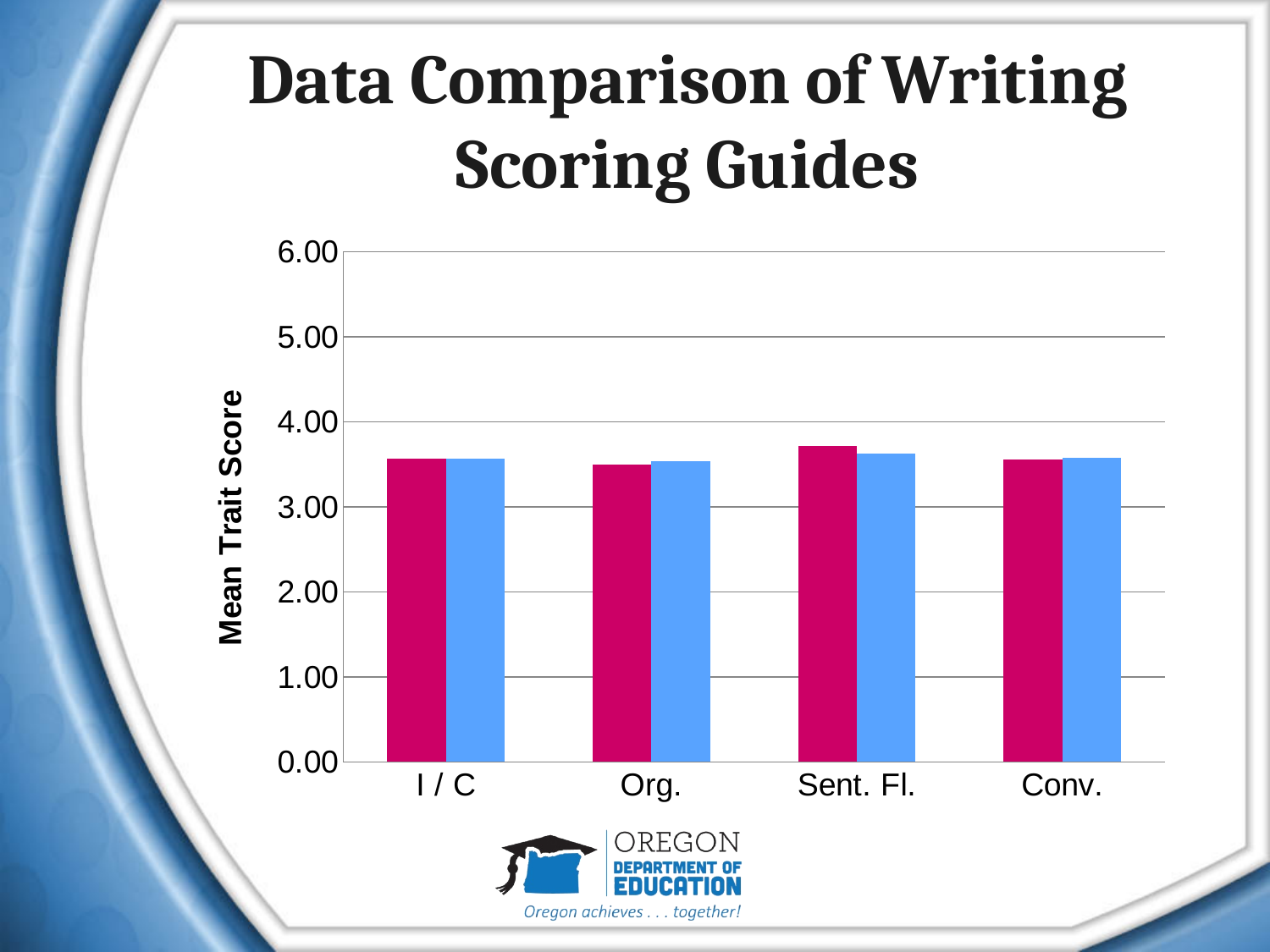
Is the value of the blue bar for Conv. greater or less than 3.00? greater What is the highest value shown on the chart's vertical axis? 6.00 What is the title of the chart's vertical axis? Mean Trait Score Is the value of the magenta bar for Org. greater or less than 3.00? greater Is the value of the magenta bar for Sent. Fl. greater or less than 4.00? less What kind of chart is shown on the slide? bar chart How many bars are plotted for each category in the chart? 2 Which category has the tallest magenta bar? Sent. Fl. What is the title of the slide containing the chart? Data Comparison of Writing Scoring Guides For Sent. Fl., which bar is taller, the magenta bar or the blue bar? the magenta bar How many categories are shown on the x axis of the chart? 4